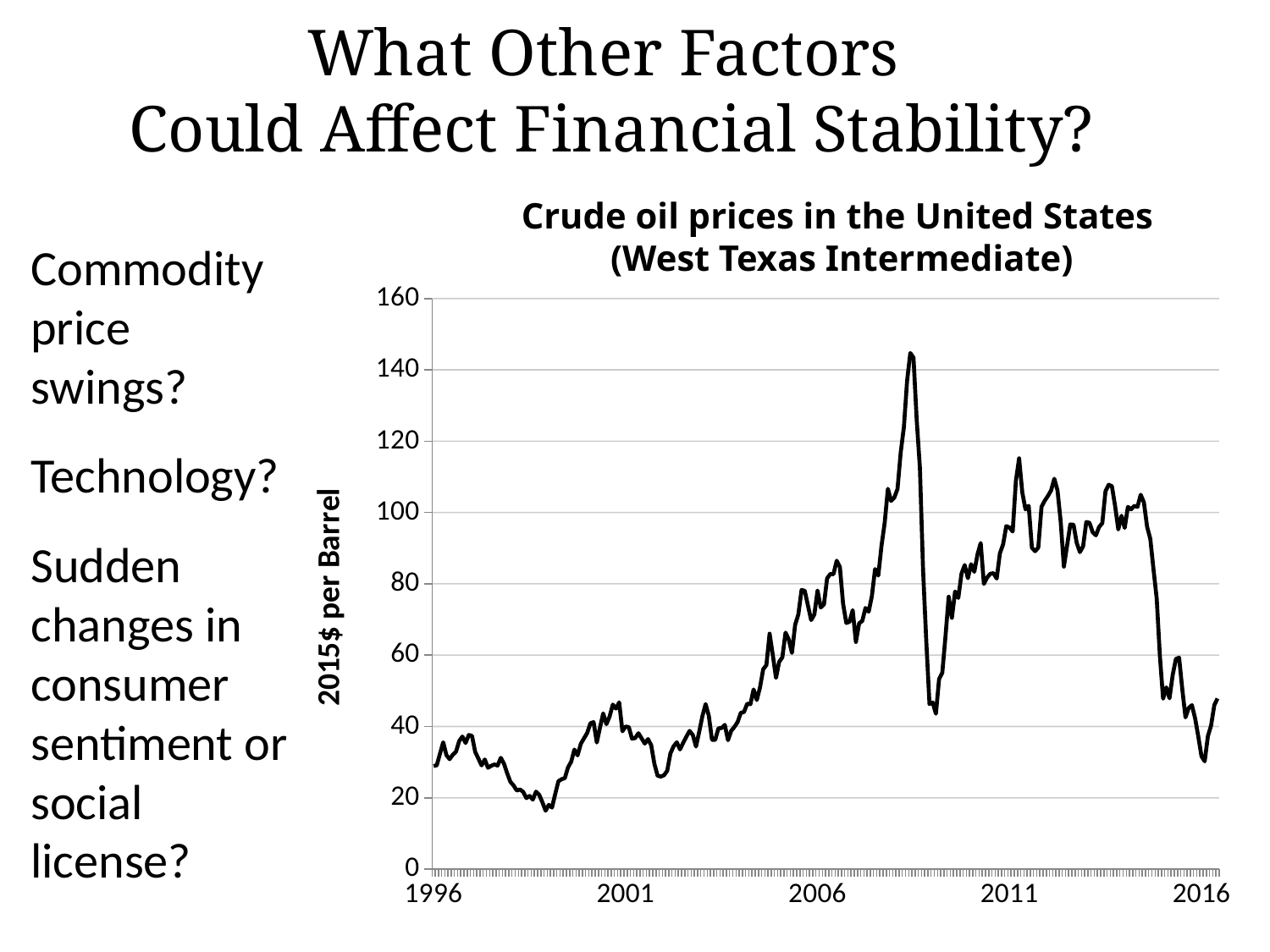
Is the highest value reached by the line greater or less than 140? greater Which is larger: the peak value around 2008 or the peak value around 2011? the peak around 2008 Is the lowest value on the chart, reached between 1996 and 2001, greater or less than 20? less Does the line rise or fall between 2014 and 2016? fall How many year labels are shown on the horizontal axis? 5 Is the value at 2011 greater or less than 80? greater What kind of chart is shown on the slide? line chart What is the title of the chart? Crude oil prices in the United States (West Texas Intermediate) Does the line generally rise or fall between 2001 and 2006? rise What is the label on the vertical axis of the chart? 2015$ per Barrel